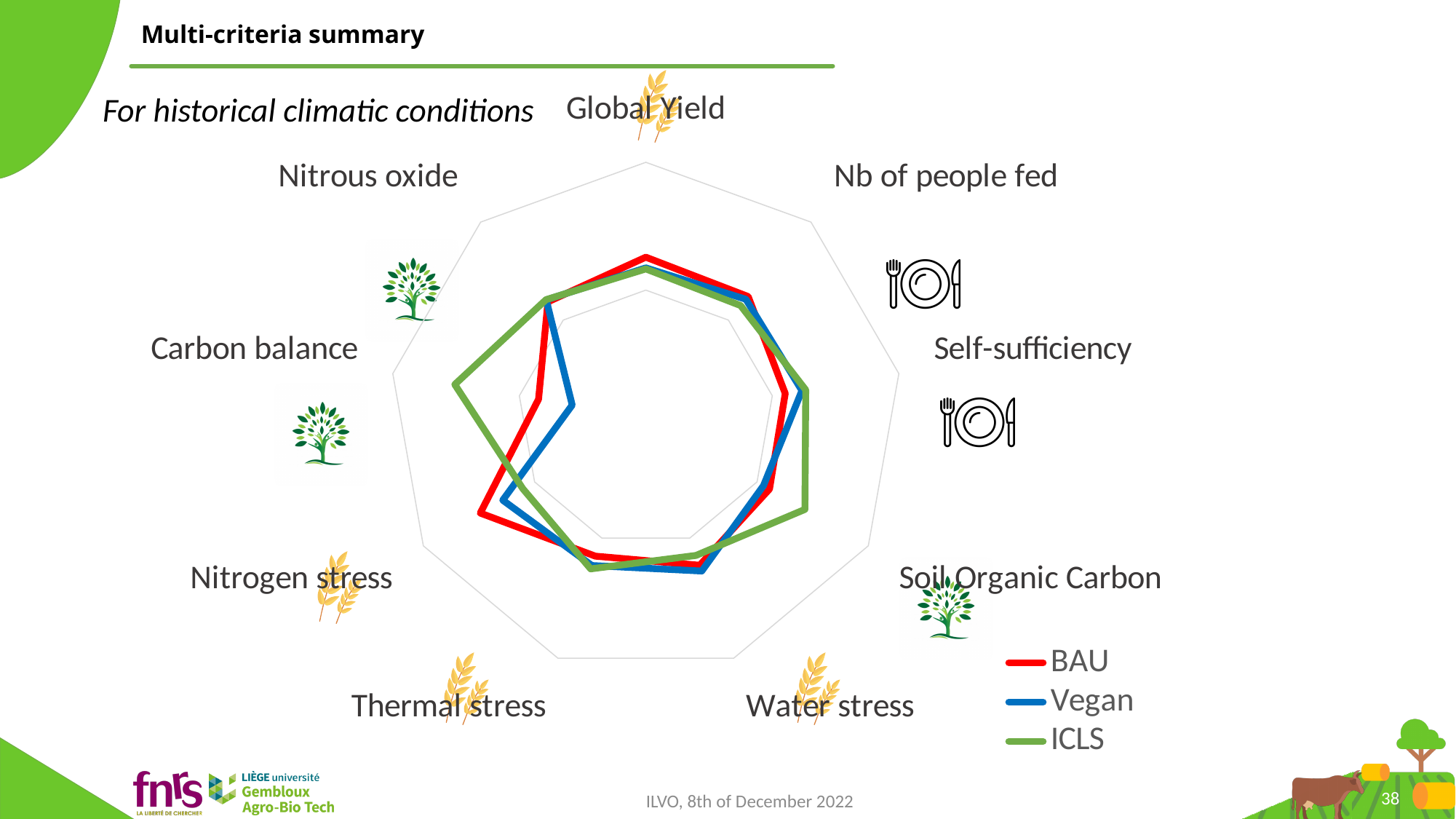
For Carbon balance, which is larger: ICLS or Vegan? ICLS For Soil Organic Carbon, which is larger: ICLS or BAU? ICLS Which series has the highest value for Carbon balance? ICLS Which series has the highest value for Nitrogen stress? BAU Which colour represents the ICLS series? Green Which series are listed in the legend? BAU, Vegan, ICLS Which series has the lowest value for Nitrogen stress? ICLS How many criteria (axes) does the radar chart have? 9 How many series does the legend list? 3 Which series has the highest value for Soil Organic Carbon? ICLS What kind of chart is shown on the slide? Radar chart For Nitrogen stress, which is larger: BAU or ICLS? BAU